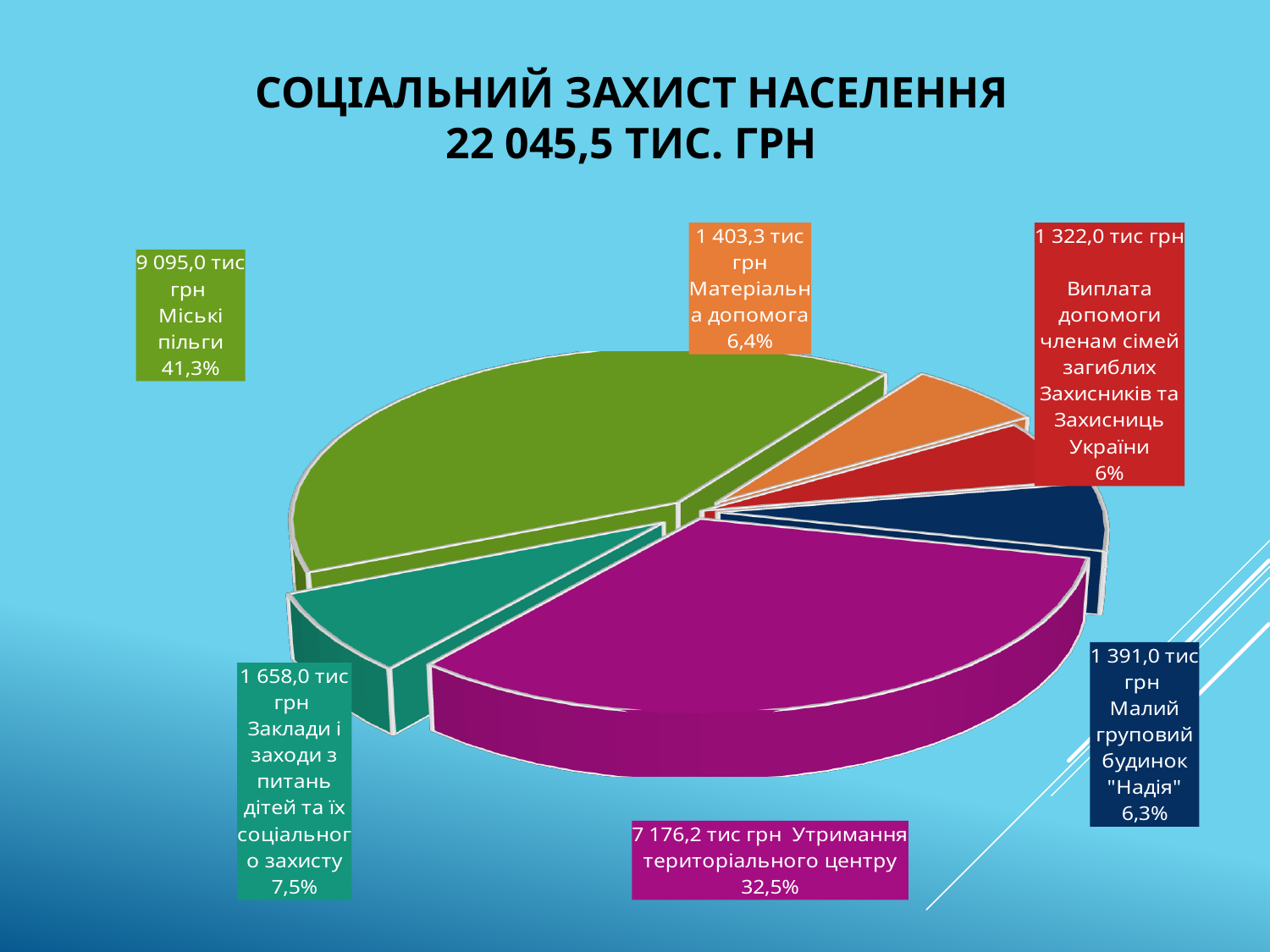
What share of the pie does Утримання територіального центру represent? 32,5% What is the difference in percentage points between Міські пільги and Утримання територіального центру? 8,8 What colour is the slice for Утримання територіального центру? Magenta Which category has the largest share of the pie? Міські пільги What percentage is shown for Матеріальна допомога? 6,4% What total amount is stated in the chart title? 22 045,5 тис. грн Which category has the smallest share of the pie? Виплата допомоги членам сімей загиблих Захисників та Захисниць України Which is larger: Заклади і заходи з питань дітей та їх соціального захисту or Матеріальна допомога? Заклади і заходи з питань дітей та їх соціального захисту How many slices does the pie chart have? 6 What type of chart is shown on the slide? Pie chart What is the value for Міські пільги? 9 095,0 тис грн What is the value for Малий груповий будинок "Надія"? 1 391,0 тис грн